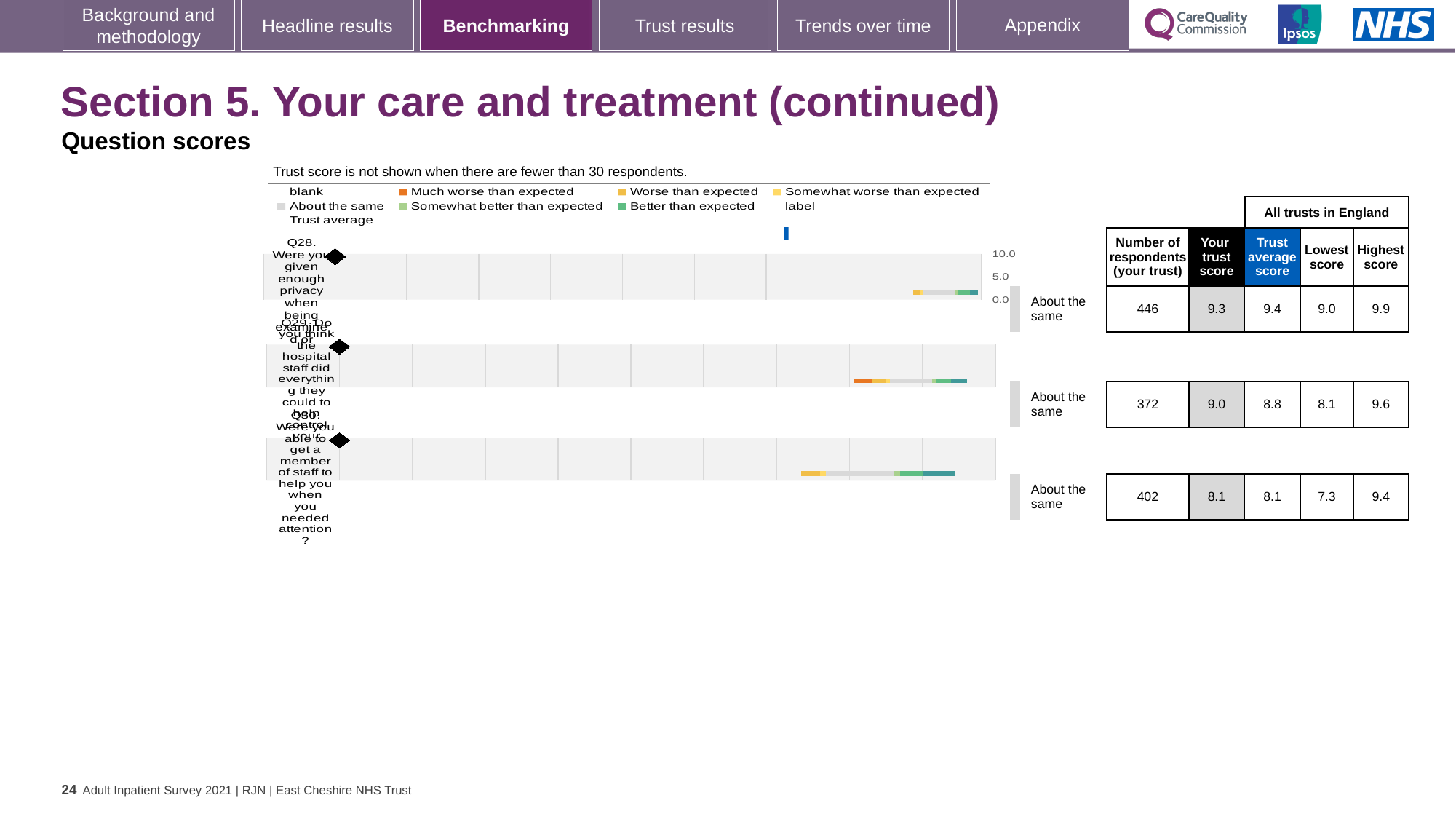
Which question has the highest trust score? Q28 What kind of chart is used to show the question scores for Q28, Q29 and Q30? bar chart How many respondents answered Q29 at this trust? 372 What is the difference between the highest and lowest scores for Q29? 1.5 What is the trust score for Q28? 9.3 What is the difference between the trust average score and the trust score for Q28? 0.1 How many questions (Q28, Q29, Q30) are plotted on the slide? 3 What is the highest score across all trusts in England for Q30? 9.4 Is the trust score for Q28 greater or less than 5.0? greater What benchmark category is shown for all three questions? About the same For Q29, which is larger: the trust score or the trust average score? trust score Which question has the lowest trust score? Q30